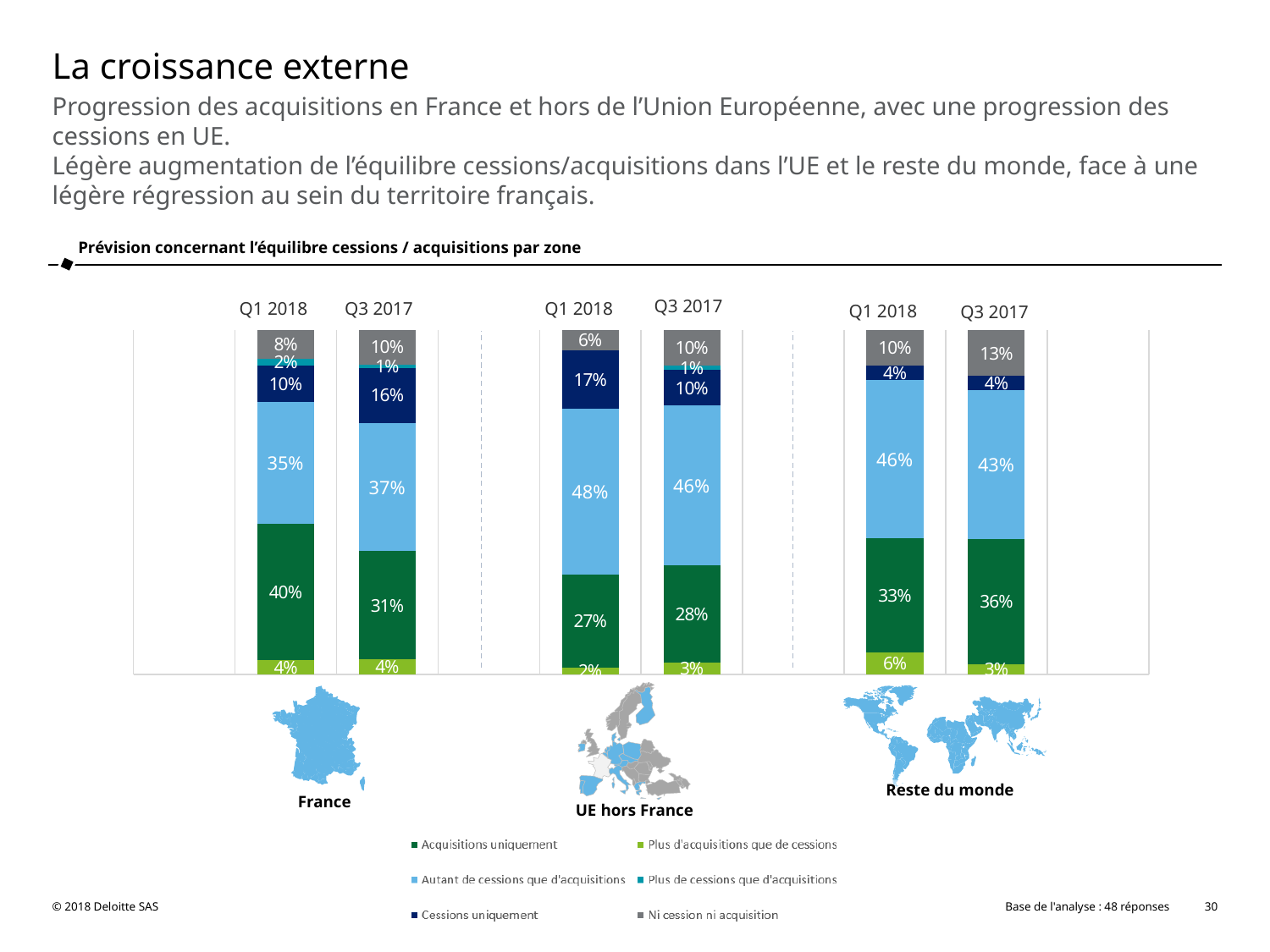
Which zone has the highest 'Acquisitions uniquement' value in Q1 2018? France What is the value for 'Cessions uniquement' in the France Q3 2017 bar? 16% What is the value for 'Autant de cessions que d'acquisitions' in the UE hors France Q1 2018 bar? 48% What kind of chart is shown on the slide? stacked bar chart What is the value for 'Ni cession ni acquisition' in the Reste du monde Q3 2017 bar? 13% How many series does the legend list? 6 What is the title of the chart? Prévision concernant l'équilibre cessions / acquisitions par zone Which zone has the lowest 'Plus d'acquisitions que de cessions' value in Q1 2018? UE hors France How many bars are plotted in the chart? 6 What is the value for 'Acquisitions uniquement' in the France Q1 2018 bar? 40% What is the difference between the 'Acquisitions uniquement' values for France in Q1 2018 and Q3 2017? 9% Which is larger: 'Autant de cessions que d'acquisitions' for Reste du monde in Q1 2018 or in Q3 2017? Q1 2018